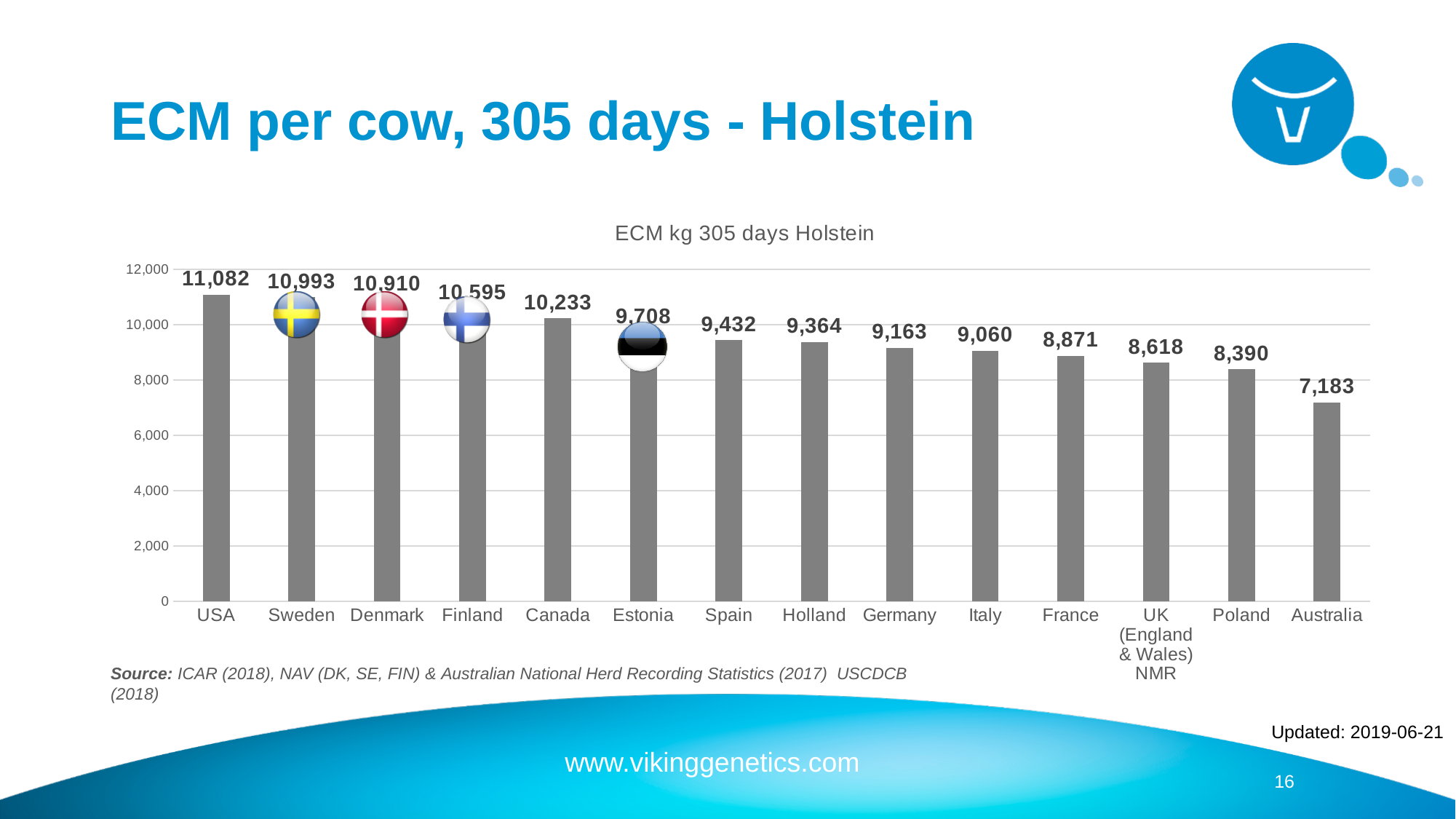
What is the ECM kg value for the USA? 11,082 Which country has the highest ECM kg value? USA What is the difference between the ECM kg values for USA and Australia? 3,899 How many countries are shown in the chart? 14 What is the ECM kg value for Canada? 10,233 What is the ECM kg value for Poland? 8,390 What is the title of the chart? ECM kg 305 days Holstein What kind of chart is shown on the slide? bar chart What is the difference between the ECM kg values for Sweden and Denmark? 83 Which has a higher ECM kg value, Spain or Holland? Spain Is the value for Estonia greater or less than 10,000? less Which country has the lowest ECM kg value? Australia